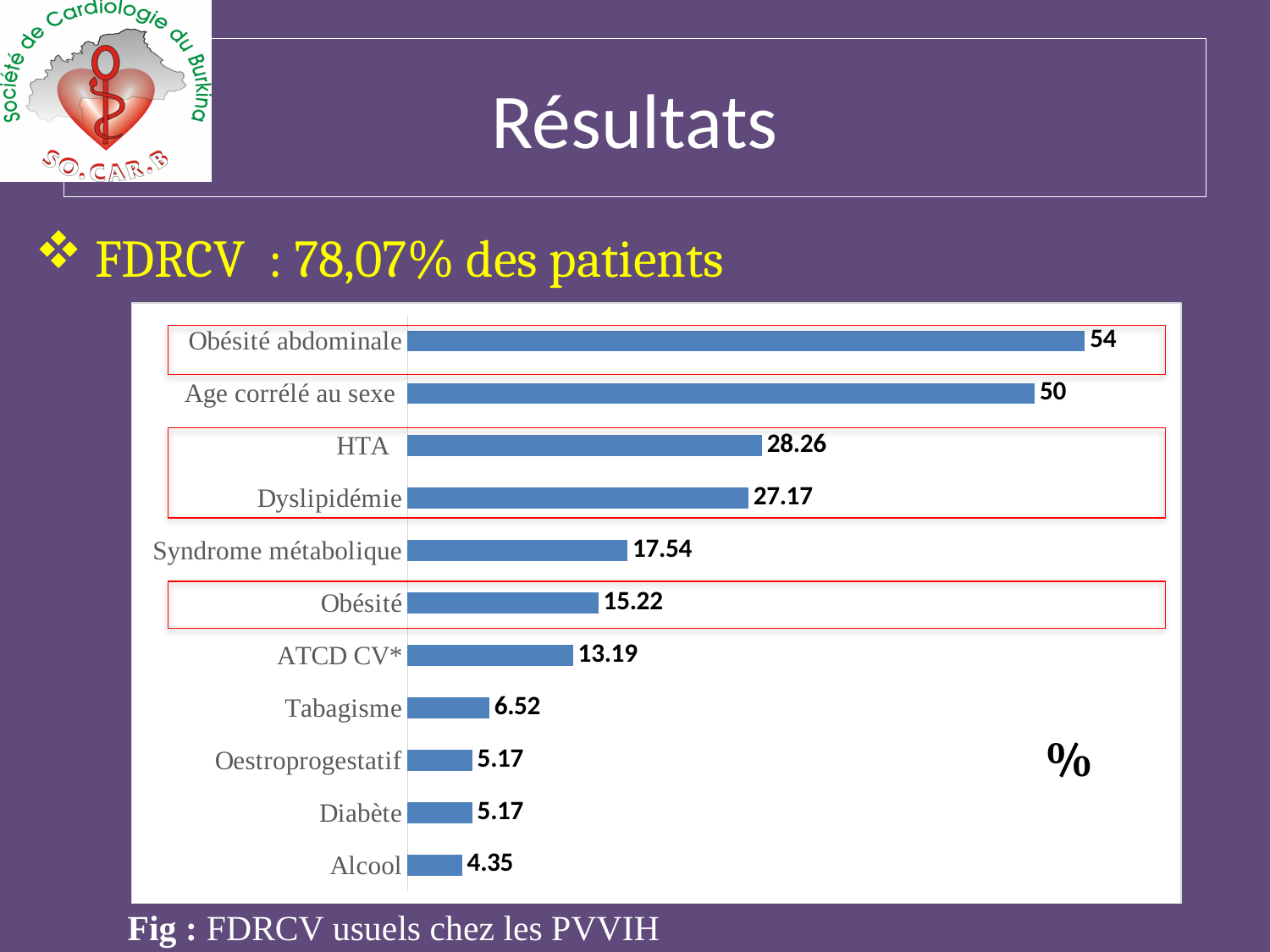
What is the difference between the values for HTA and Dyslipidémie? 1.09 How many categories are shown in the chart? 11 Which category has the lowest value? Alcool Which is larger, the value for Obésité or the value for ATCD CV*? Obésité What is the value for Tabagisme? 6.52 What kind of chart is shown on the slide? Bar chart What is the value for Syndrome métabolique? 17.54 What is the value for Obésité abdominale? 54 What is the caption of the figure below the chart? Fig : FDRCV usuels chez les PVVIH Which category has the highest value? Obésité abdominale What is the value for HTA? 28.26 What is the difference between the values for Obésité abdominale and Age corrélé au sexe? 4